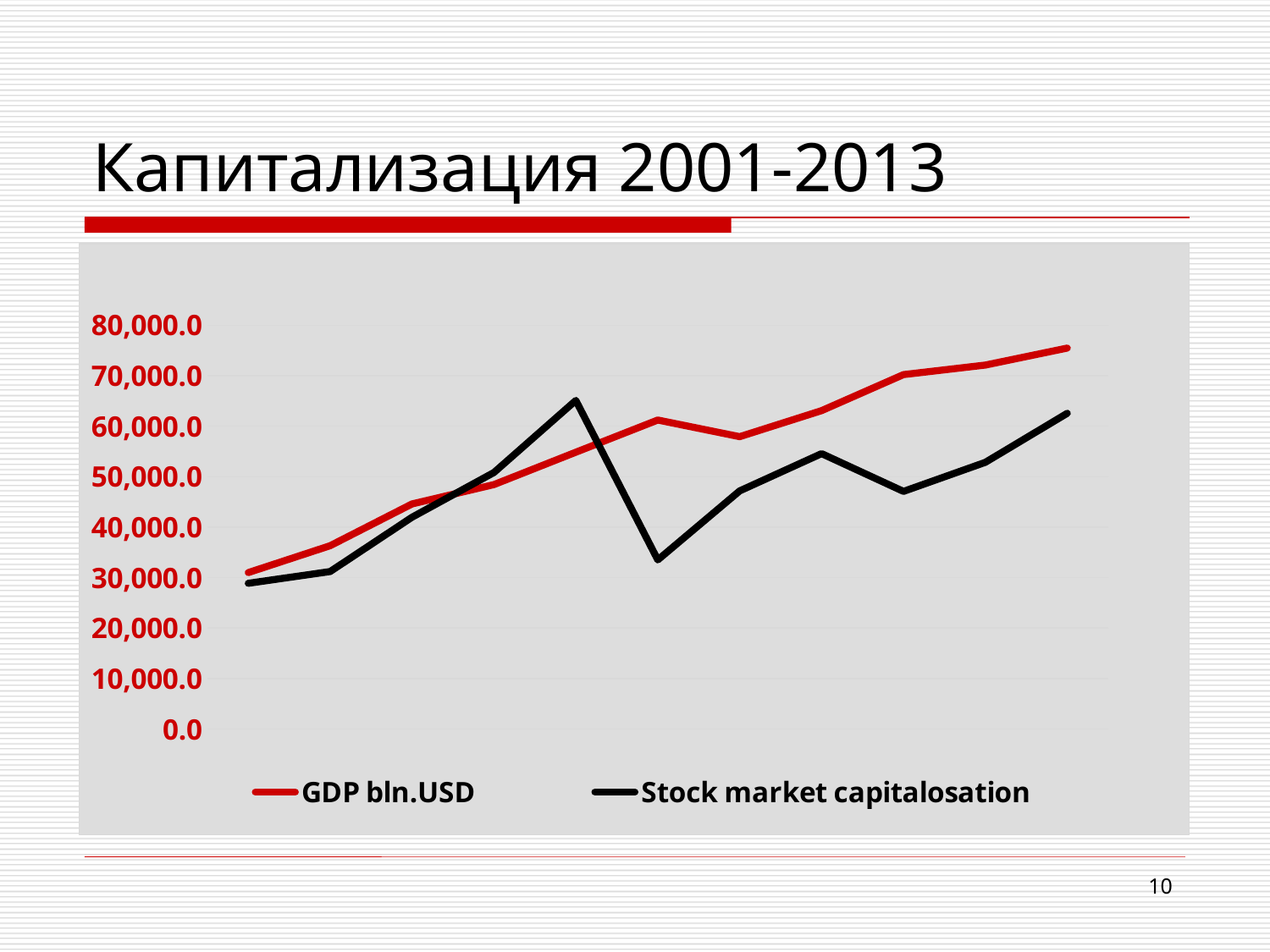
What kind of chart is shown on the slide? line chart Is the first (leftmost) value of the GDP bln.USD line greater or less than 40,000.0? less Which series reaches the highest value anywhere on the chart? GDP bln.USD Is the highest point of the Stock market capitalosation line greater or less than 60,000.0? greater How many series does the legend list? 2 Which series is drawn in red? GDP bln.USD Is the final (rightmost) value of the GDP bln.USD line greater or less than 70,000.0? greater At the rightmost point, which series has the higher value? GDP bln.USD What is the title of the slide? Капитализация 2001-2013 Does the GDP bln.USD line generally rise or fall from left to right? rise